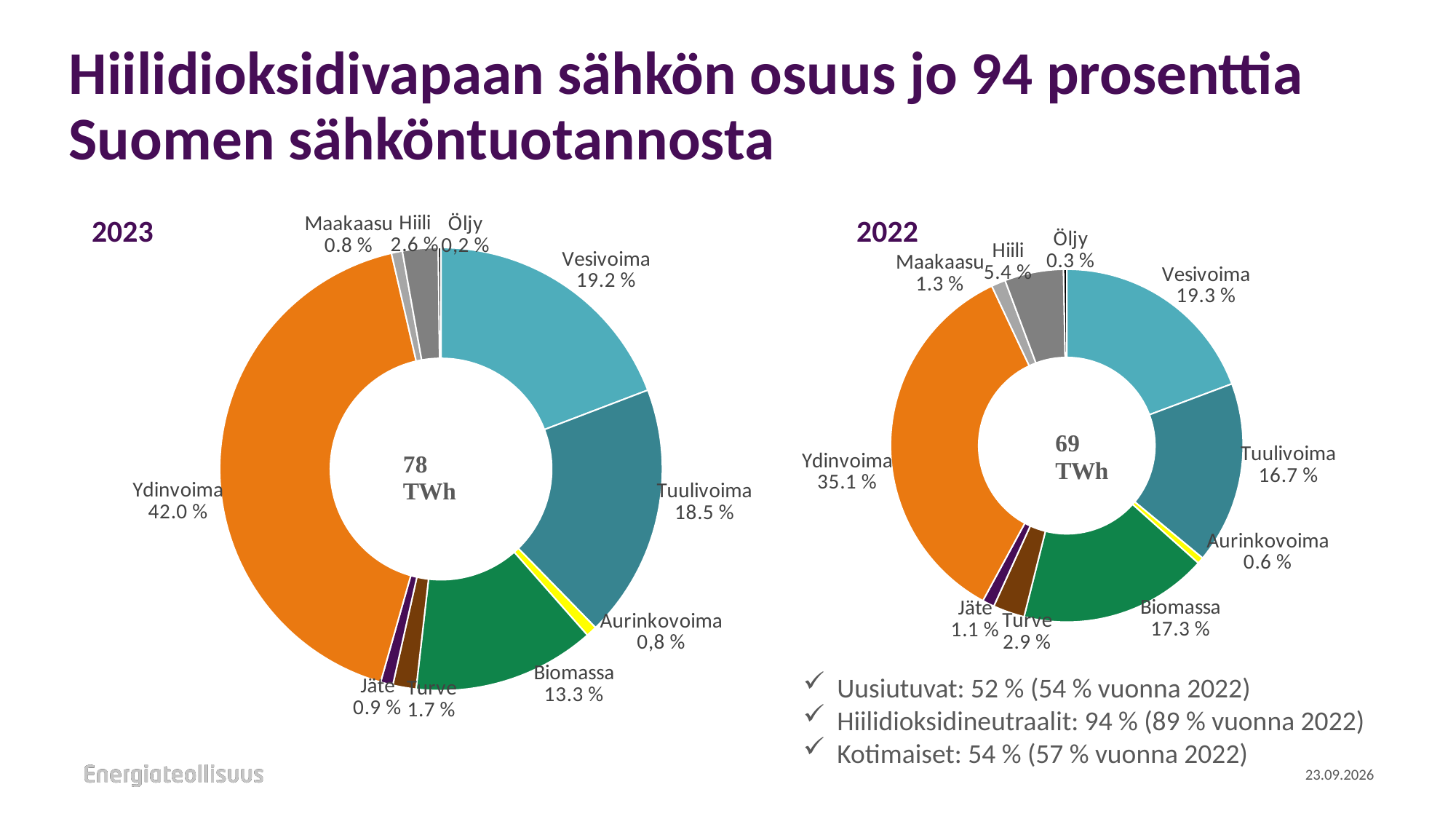
What kind of chart is the 2022 chart? Donut (pie) chart In the 2023 chart, what is the share for Ydinvoima? 42.0 % What is the difference between the Ydinvoima share in the 2023 chart and in the 2022 chart? 6.9 % In the 2022 chart, what is the share for Biomassa? 17.3 % In the 2023 chart, which category has the smallest share? Öljy In the 2022 chart, what is the share for Hiili? 5.4 % What total is printed in the centre of the 2023 chart? 78 TWh In the 2022 chart, which is larger, Vesivoima or Tuulivoima? Vesivoima In the 2022 chart, which category has the smallest share? Öljy In the 2023 chart, what is the share for Tuulivoima? 18.5 % How many categories does the 2023 chart show? 10 In the 2023 chart, which category has the largest share? Ydinvoima